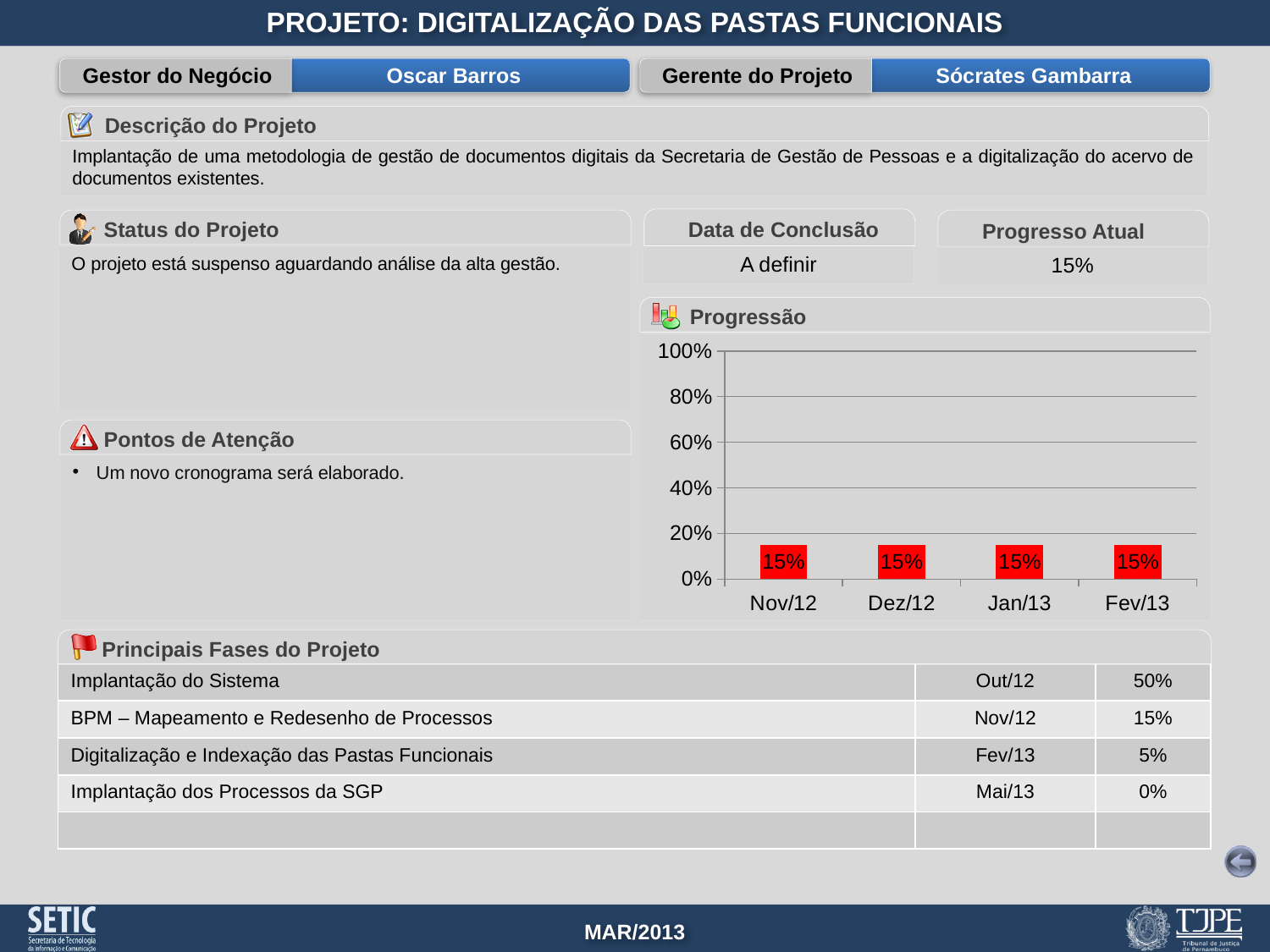
What kind of chart is the Progressão chart? bar chart What is the first category on the x axis of the Progressão chart? Nov/12 What is the difference between the values for Dez/12 and Nov/12 in the Progressão chart? 0% Is the value for Dez/12 in the Progressão chart greater or less than 20%? less What is the value for Nov/12 in the Progressão chart? 15% Do the values in the Progressão chart rise, fall or stay flat from Nov/12 to Fev/13? stay flat How many categories are shown on the x axis of the Progressão chart? 4 What colour are the bars in the Progressão chart? red What is the highest value shown on the y axis of the Progressão chart? 100% What is the value for Jan/13 in the Progressão chart? 15% What is the value for Fev/13 in the Progressão chart? 15%